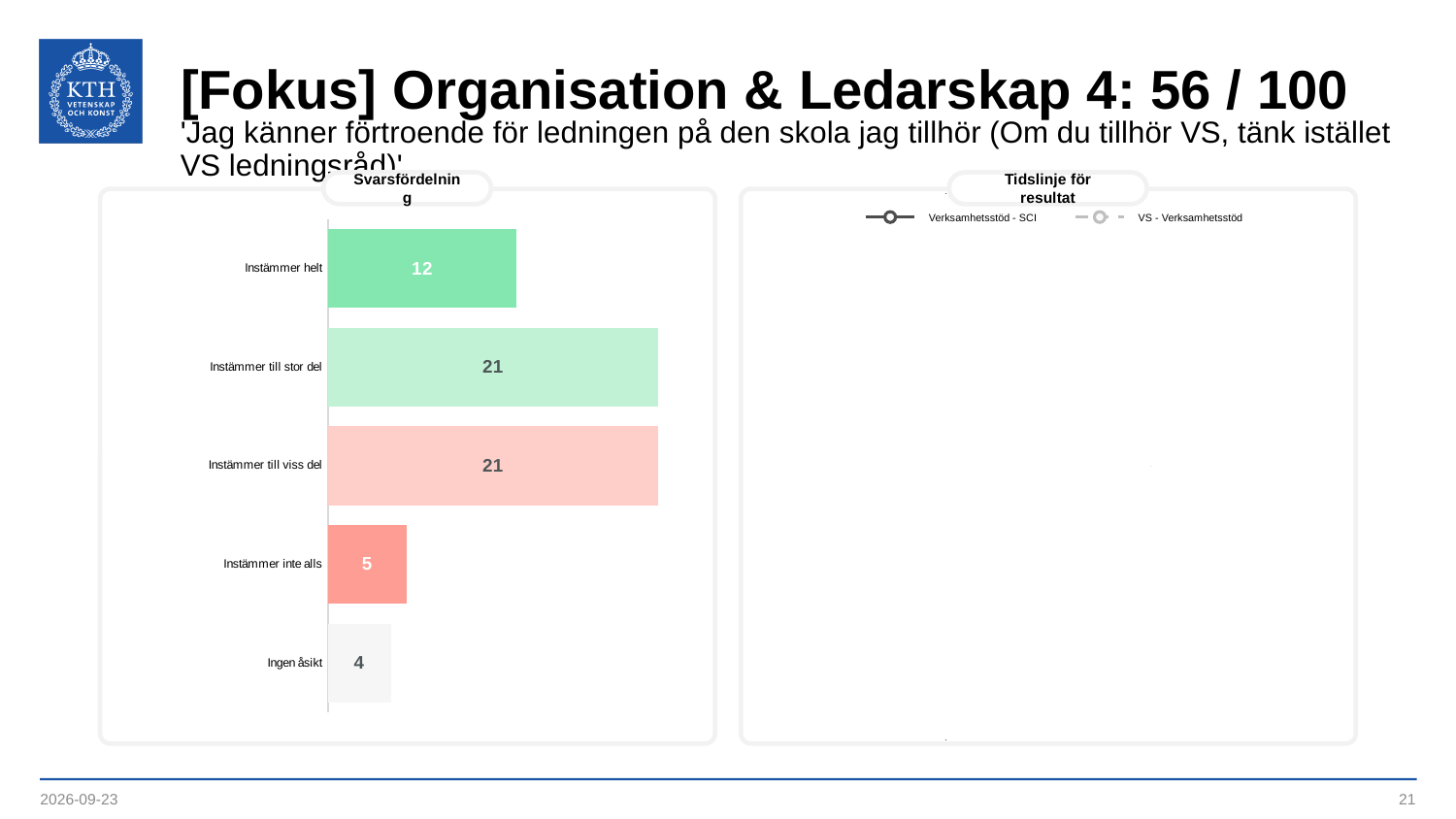
In the Svarsfördelning chart, what is the value for Instämmer till stor del? 21 In the Svarsfördelning chart, which is larger: Instämmer helt or Instämmer inte alls? Instämmer helt How many series does the legend of the Tidslinje för resultat chart list? 2 In the Svarsfördelning chart, which category has the lowest value? Ingen åsikt In the Svarsfördelning chart, what is the difference between Instämmer till stor del and Instämmer helt? 9 In the Svarsfördelning chart, what is the value for Instämmer inte alls? 5 In the Svarsfördelning chart, what is the difference between Instämmer inte alls and Ingen åsikt? 1 What kind of chart is the Svarsfördelning chart? Bar chart In the Svarsfördelning chart, what is the value for Ingen åsikt? 4 How many categories does the Svarsfördelning chart show? 5 In the Svarsfördelning chart, what is the value for Instämmer helt? 12 What are the two legend entries in the Tidslinje för resultat chart? Verksamhetsstöd - SCI and VS - Verksamhetsstöd